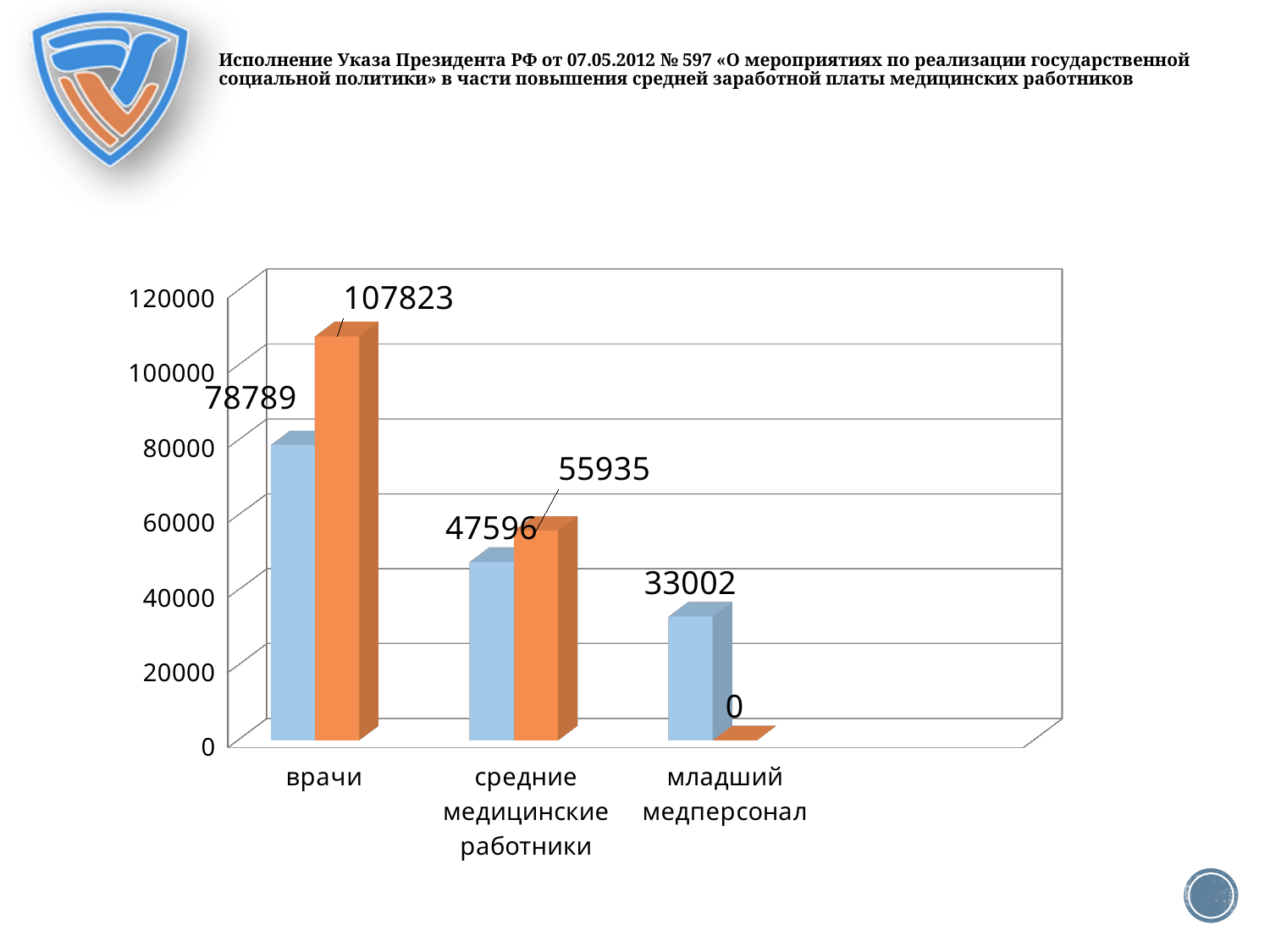
Which category has the highest orange bar? врачи For средние медицинские работники, which bar is larger, the blue or the orange? orange Which category has the lowest blue bar? младший медперсонал What is the difference between the orange and blue bars for врачи? 29034 What is the value of the orange bar for младший медперсонал? 0 What is the value of the blue bar for врачи? 78789 How many categories are shown on the x axis? 3 What is the value of the orange bar for средние медицинские работники? 55935 What is the value of the orange bar for врачи? 107823 What is the value of the blue bar for средние медицинские работники? 47596 What is the value of the blue bar for младший медперсонал? 33002 What kind of chart is shown on the slide? bar chart